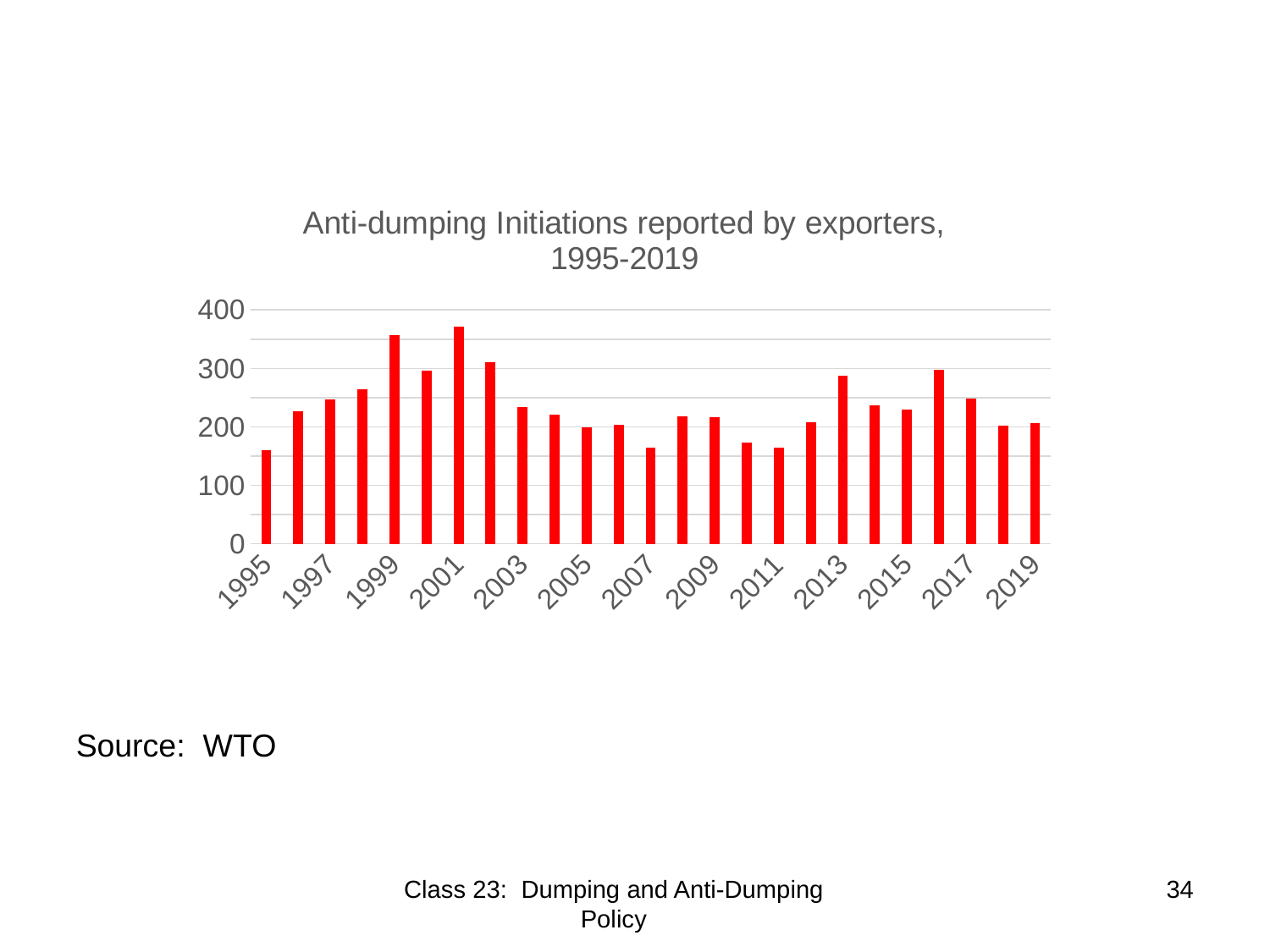
Which year has the larger value, 2001 or 2013? 2001 What kind of chart is shown on the slide? bar chart Is the value for 2013 greater or less than 200? greater How many years (bars) are plotted in the chart? 25 Do the values rise or fall from 1995 to 2001? rise Is the value for 1995 greater or less than 200? less Is the value for 2011 greater or less than 200? less Which year has the larger value, 1999 or 2011? 1999 What is the title of the chart? Anti-dumping Initiations reported by exporters, 1995-2019 Which year has the highest number of anti-dumping initiations? 2001